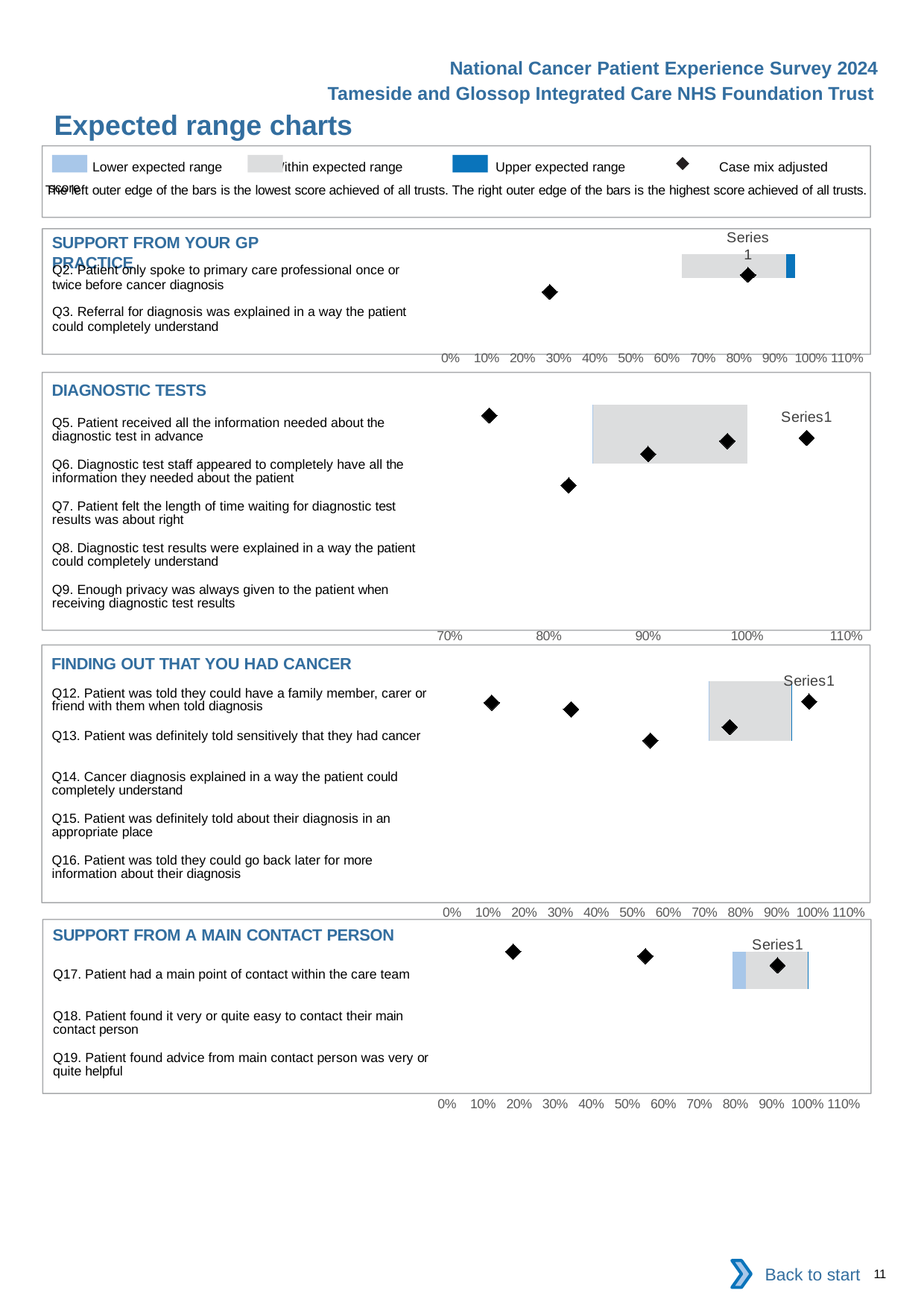
How many questions are listed in the FINDING OUT THAT YOU HAD CANCER chart? 5 How many questions are listed in the DIAGNOSTIC TESTS chart? 5 In the DIAGNOSTIC TESTS chart, what is the lowest value shown on the x axis? 70% In the SUPPORT FROM A MAIN CONTACT PERSON chart, what series name is shown next to the bar? Series1 According to the legend, what does the diamond marker represent? Case mix adjusted score How many diamond markers are plotted in the SUPPORT FROM A MAIN CONTACT PERSON chart? 3 In the FINDING OUT THAT YOU HAD CANCER chart, what is the highest value shown on the x axis? 110%